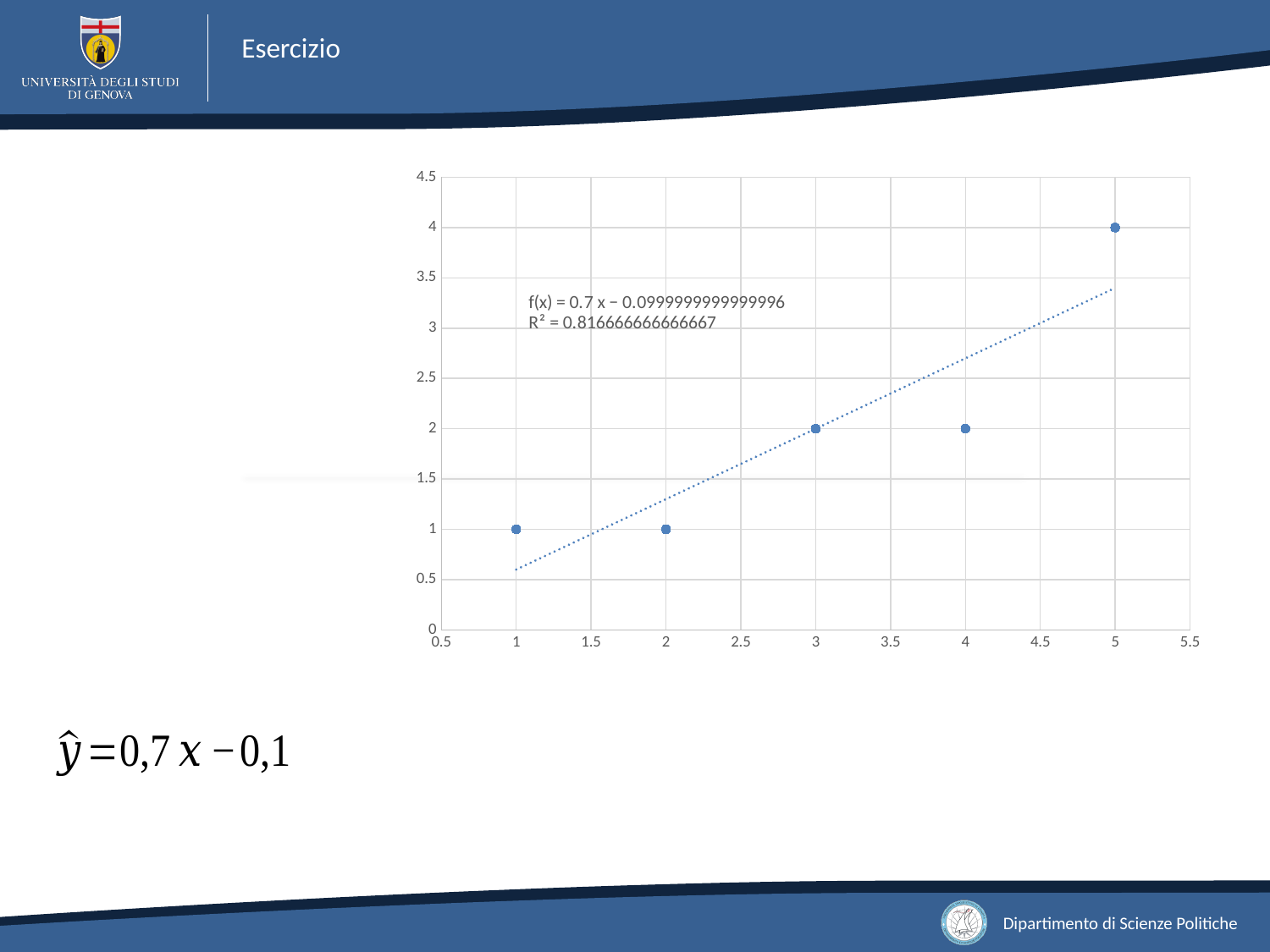
Is the y value of the data point at x = 5 greater or less than 3.5? greater What R² value is displayed on the chart? 0.816666666666667 Which has a larger y value, the point at x = 3 or the point at x = 2? the point at x = 3 What is the y value of the data point at x = 1? 1 At which x value does the data point with the highest y value occur? 5 What is the y value of the data point at x = 3? 2 What kind of chart is shown on the slide? scatter plot Do the y values generally rise or fall as x increases? rise What is the slope of the trendline equation f(x) shown on the chart? 0.7 What is the y value of the data point at x = 5? 4 What is the difference between the y values of the points at x = 5 and x = 4? 2 How many data points are plotted on the chart? 5